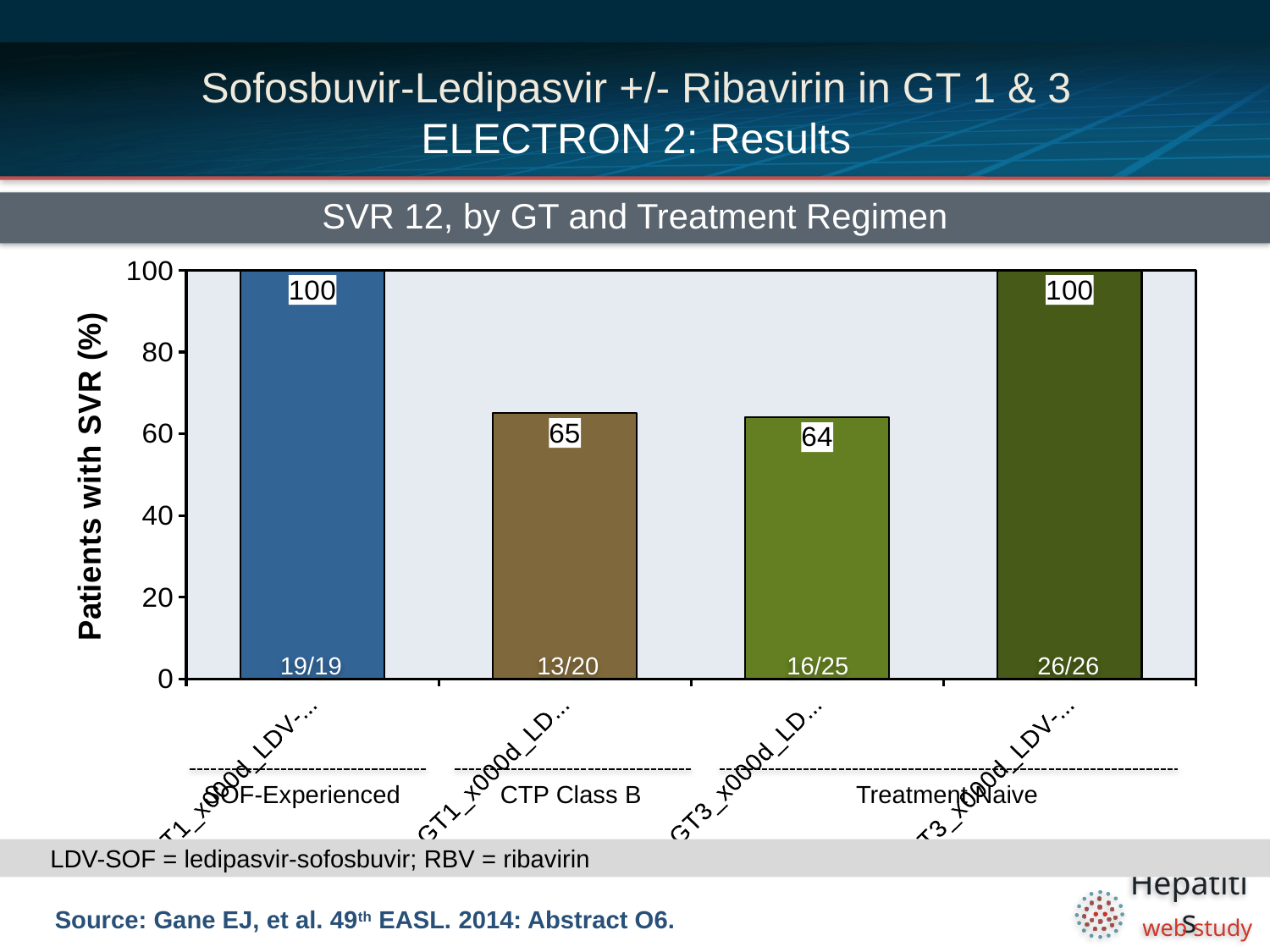
What patient fraction is printed at the bottom of the second (brown) bar? 13/20 What is the SVR value shown on the second (brown) bar? 65 What is the SVR value shown on the fourth (rightmost, dark green) bar? 100 What type of chart is shown on the slide? bar chart How many bars are plotted in the chart? 4 What patient fraction is printed at the bottom of the fourth (rightmost) bar? 26/26 Which bar has the lowest SVR value? the third (green) bar, 64 What is the SVR value shown on the first (leftmost, blue) bar? 100 What is the label of the y-axis? Patients with SVR (%) What is the SVR value shown on the third (green) bar? 64 What is the difference between the SVR value of the first bar and the second bar? 35 Which is larger, the SVR value of the second bar or the fourth bar? the fourth bar